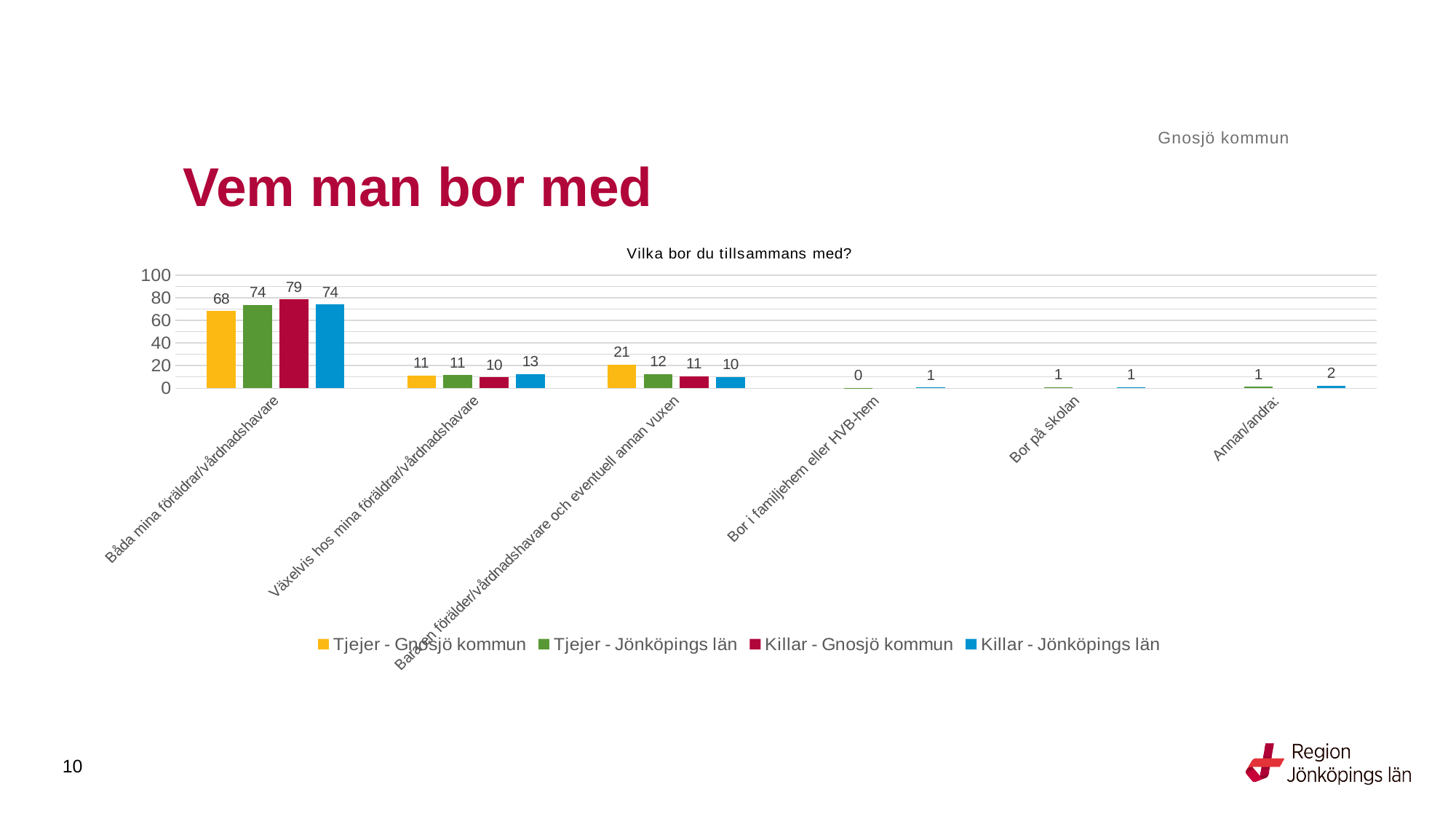
How many series does the legend list? 4 In the category 'Växelvis hos mina föräldrar/vårdnadshavare', which is larger: Killar - Jönköpings län or Killar - Gnosjö kommun? Killar - Jönköpings län What is the title of the chart? Vilka bor du tillsammans med? How many categories are shown on the x axis? 6 What is the value for Tjejer - Gnosjö kommun in the category 'Bara en förälder/vårdnadshavare och eventuell annan vuxen'? 21 In the category 'Båda mina föräldrar/vårdnadshavare', what is the difference between Killar - Gnosjö kommun and Tjejer - Gnosjö kommun? 11 What is the value for Killar - Jönköpings län in the category 'Annan/andra:'? 2 Which series has the highest value in the category 'Båda mina föräldrar/vårdnadshavare'? Killar - Gnosjö kommun Which series has the lowest value in the category 'Bara en förälder/vårdnadshavare och eventuell annan vuxen'? Killar - Jönköpings län What is the value for Tjejer - Jönköpings län in the category 'Växelvis hos mina föräldrar/vårdnadshavare'? 11 What kind of chart is shown on the slide? bar chart What is the value for Killar - Gnosjö kommun in the category 'Båda mina föräldrar/vårdnadshavare'? 79